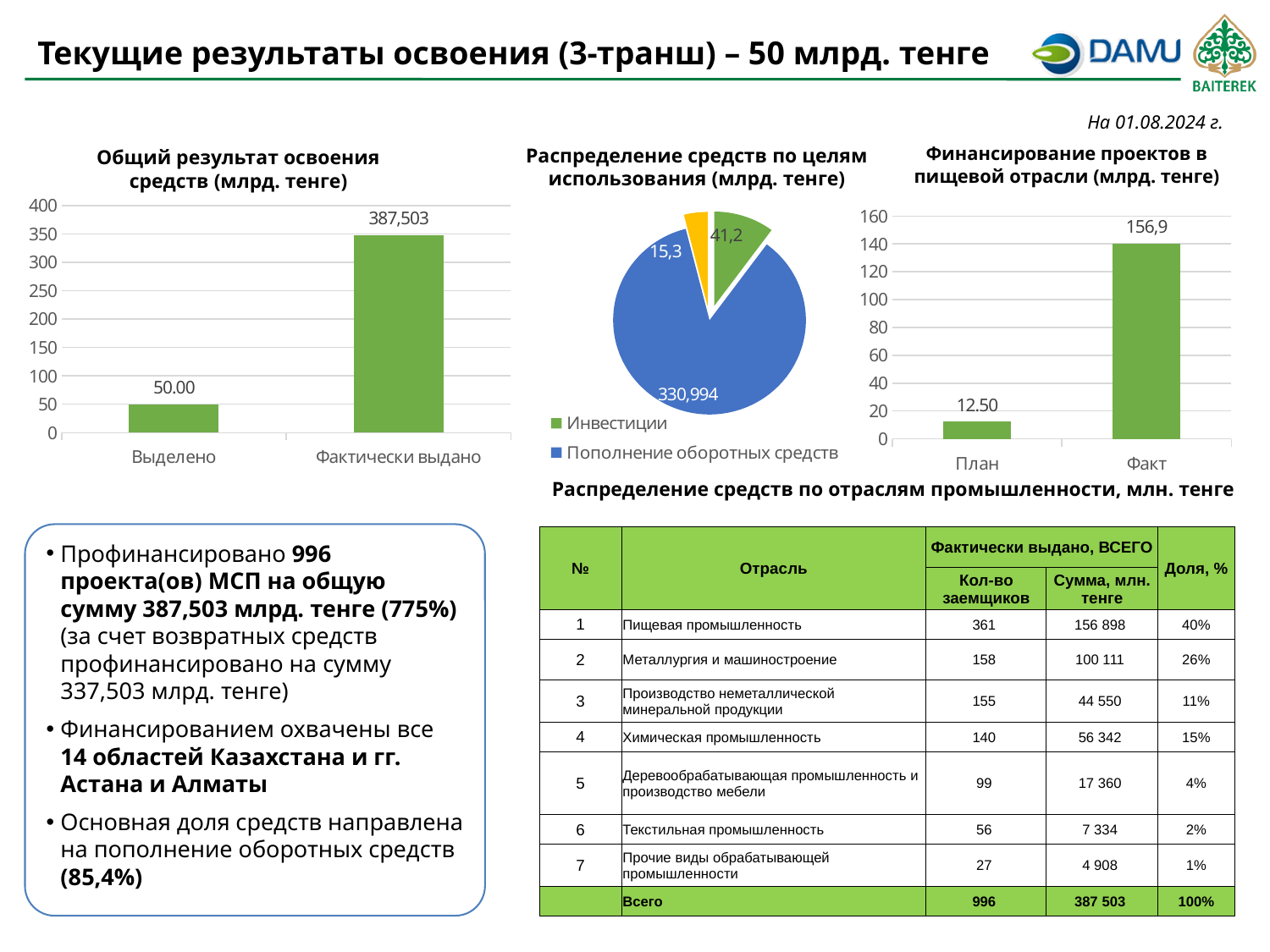
How many bars are shown in the chart 'Общий результат освоения средств (млрд. тенге)'? 2 In the pie chart 'Распределение средств по целям использования (млрд. тенге)', what is the value of the 'Инвестиции' slice? 41,2 In the pie chart 'Распределение средств по целям использования (млрд. тенге)', what is the value of the 'Пополнение оборотных средств' slice? 330,994 In the chart 'Общий результат освоения средств (млрд. тенге)', which category has the higher value? Фактически выдано In the chart 'Общий результат освоения средств (млрд. тенге)', what is the value for 'Выделено'? 50.00 What kind of chart is 'Распределение средств по целям использования (млрд. тенге)'? Pie chart In the chart 'Общий результат освоения средств (млрд. тенге)', what is the value for 'Фактически выдано'? 387,503 In the chart 'Финансирование проектов в пищевой отрасли (млрд. тенге)', what is the value for 'План'? 12.50 What kind of chart is 'Общий результат освоения средств (млрд. тенге)'? Bar chart In the pie chart 'Распределение средств по целям использования (млрд. тенге)', which slice is the largest? Пополнение оборотных средств In the chart 'Финансирование проектов в пищевой отрасли (млрд. тенге)', what is the value for 'Факт'? 156,9